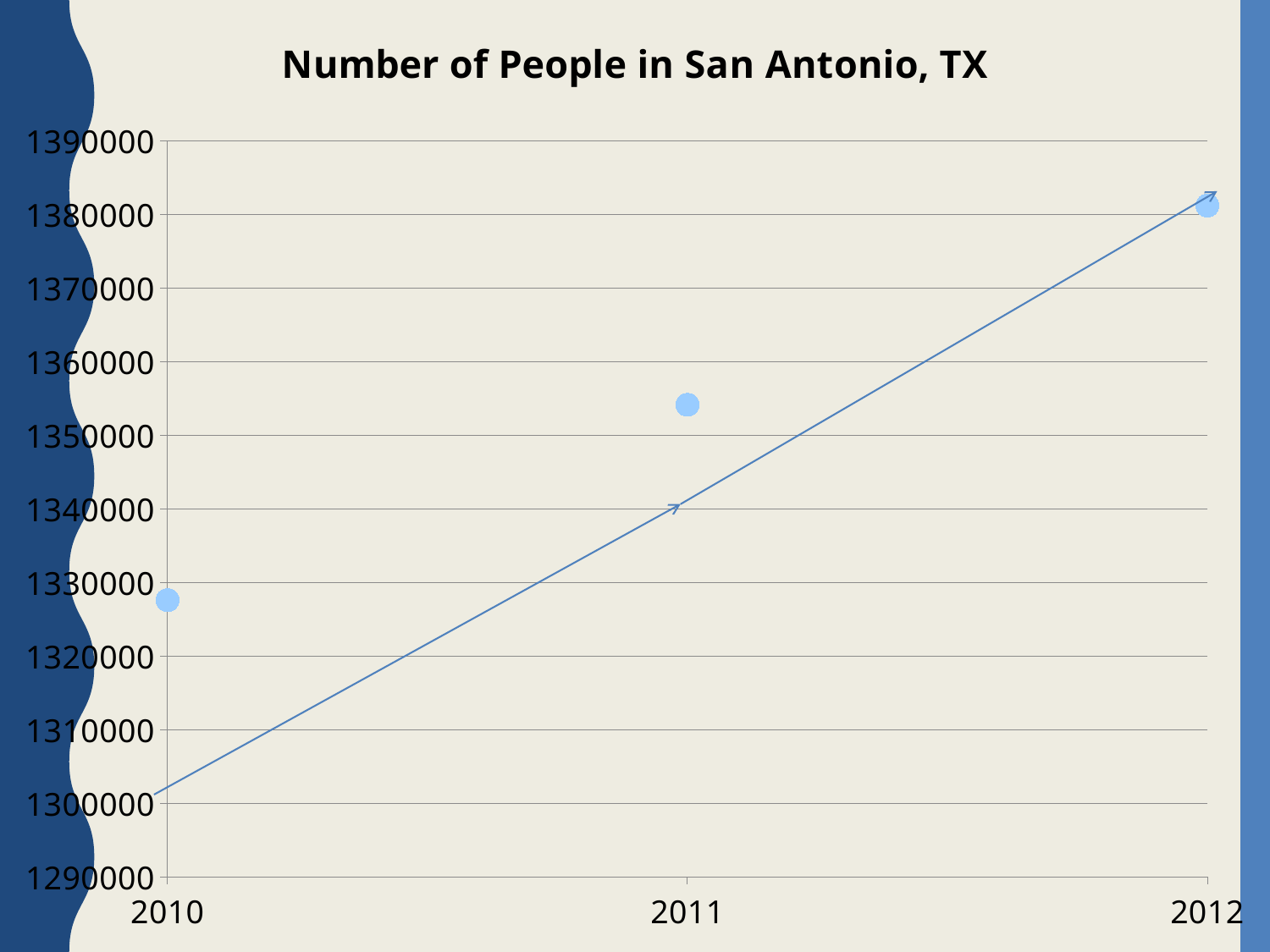
Which year has the highest number of people? 2012 What kind of chart is shown on the slide? scatter chart Which year has the lowest number of people? 2010 How many data points are plotted on the chart? 3 Which year has a larger value, 2011 or 2010? 2011 Is the value for 2010 greater or less than 1320000? greater Is the value for 2011 greater or less than 1350000? greater Which year has a larger value, 2011 or 2012? 2012 Is the value for 2011 greater or less than 1360000? less What is the title of the chart? Number of People in San Antonio, TX Do the values rise or fall from 2010 to 2012? rise